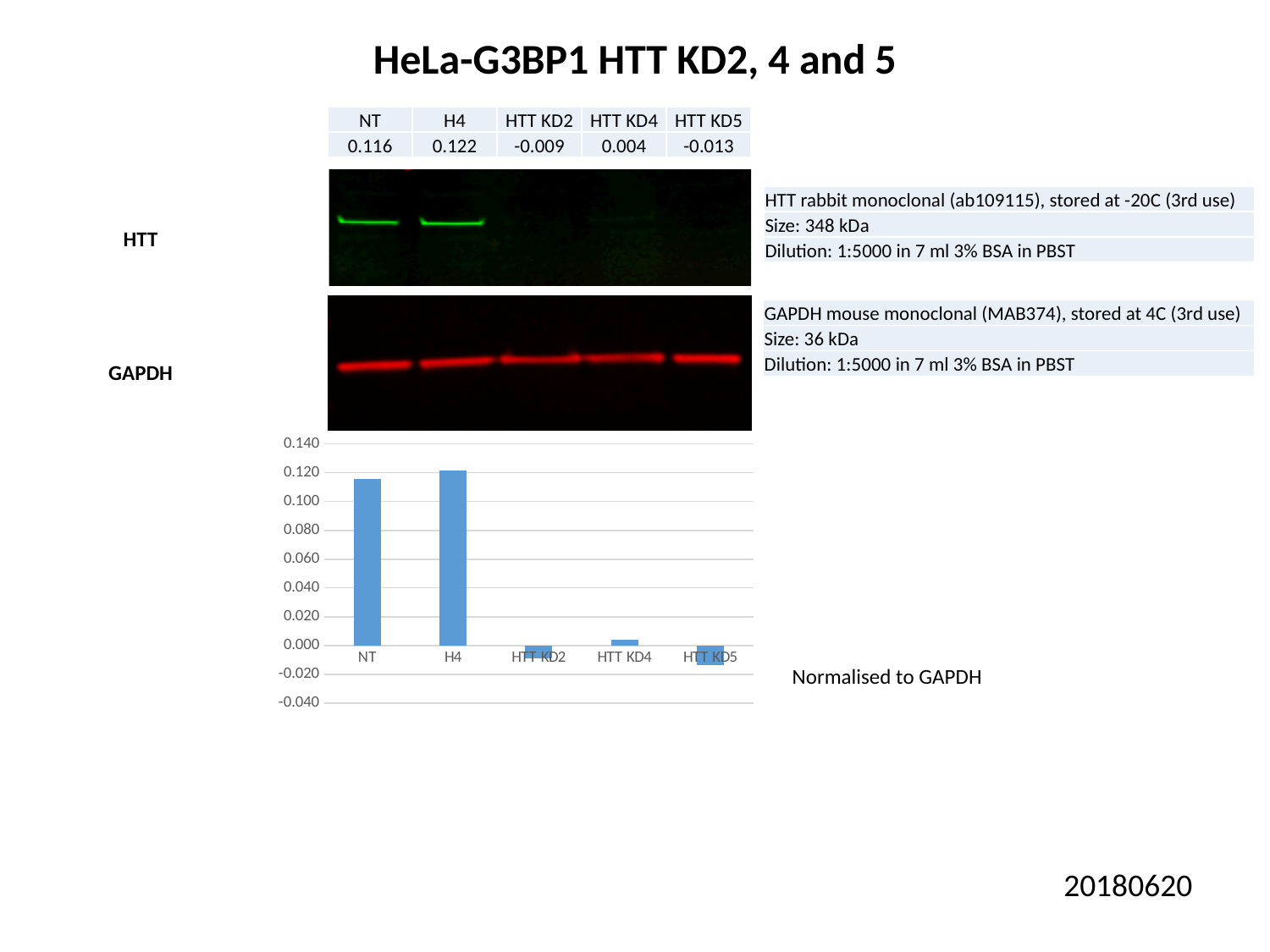
What kind of chart is shown on the slide? bar chart How many categories are plotted on the bar chart? 5 What is the value for HTT KD5 in the bar chart? -0.013 Is the value for H4 in the bar chart greater or less than 0.100? greater What is the difference between the values for H4 and NT in the bar chart? 0.006 What is the value for HTT KD2 in the bar chart? -0.009 What is the value for H4 in the bar chart? 0.122 What is the value for HTT KD4 in the bar chart? 0.004 Which category has the lowest value in the bar chart? HTT KD5 What is the value for NT in the bar chart? 0.116 Which category has the highest value in the bar chart? H4 Which is larger in the bar chart, the value for NT or the value for HTT KD4? NT